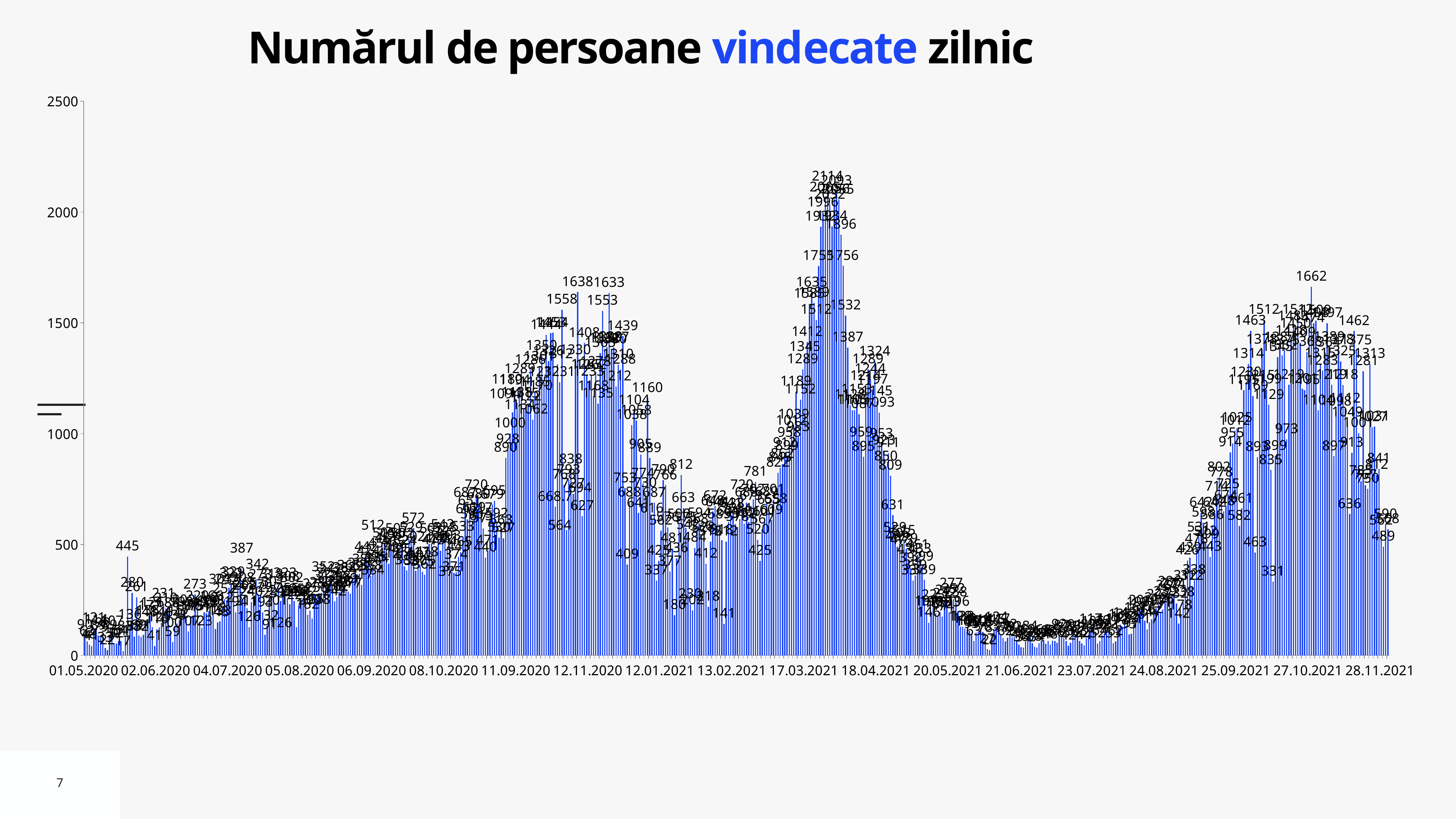
What kind of chart is shown on the slide? bar chart What is the value labeled on the tallest bar near 27.10.2021? 1662 What is the maximum value shown on the vertical axis? 2500 What is the difference between the highest peak (2114) and the peak near 27.10.2021 (1662)? 452 What is the highest value labeled on the chart? 2114 What value is labeled on the bar that stands out just before 02.06.2020? 445 Do the values rise or fall from 21.06.2021 to 25.09.2021? rise Are the values around 21.06.2021 greater or less than 500? less Is the tallest bar between 17.03.2021 and 18.04.2021 greater or less than 2000? greater What value is labeled on the bar that stands out just after 04.07.2020? 387 Which peak is higher: the one between 17.03.2021 and 18.04.2021, or the one near 27.10.2021? the one between 17.03.2021 and 18.04.2021 What is the title of the chart? Numărul de persoane vindecate zilnic